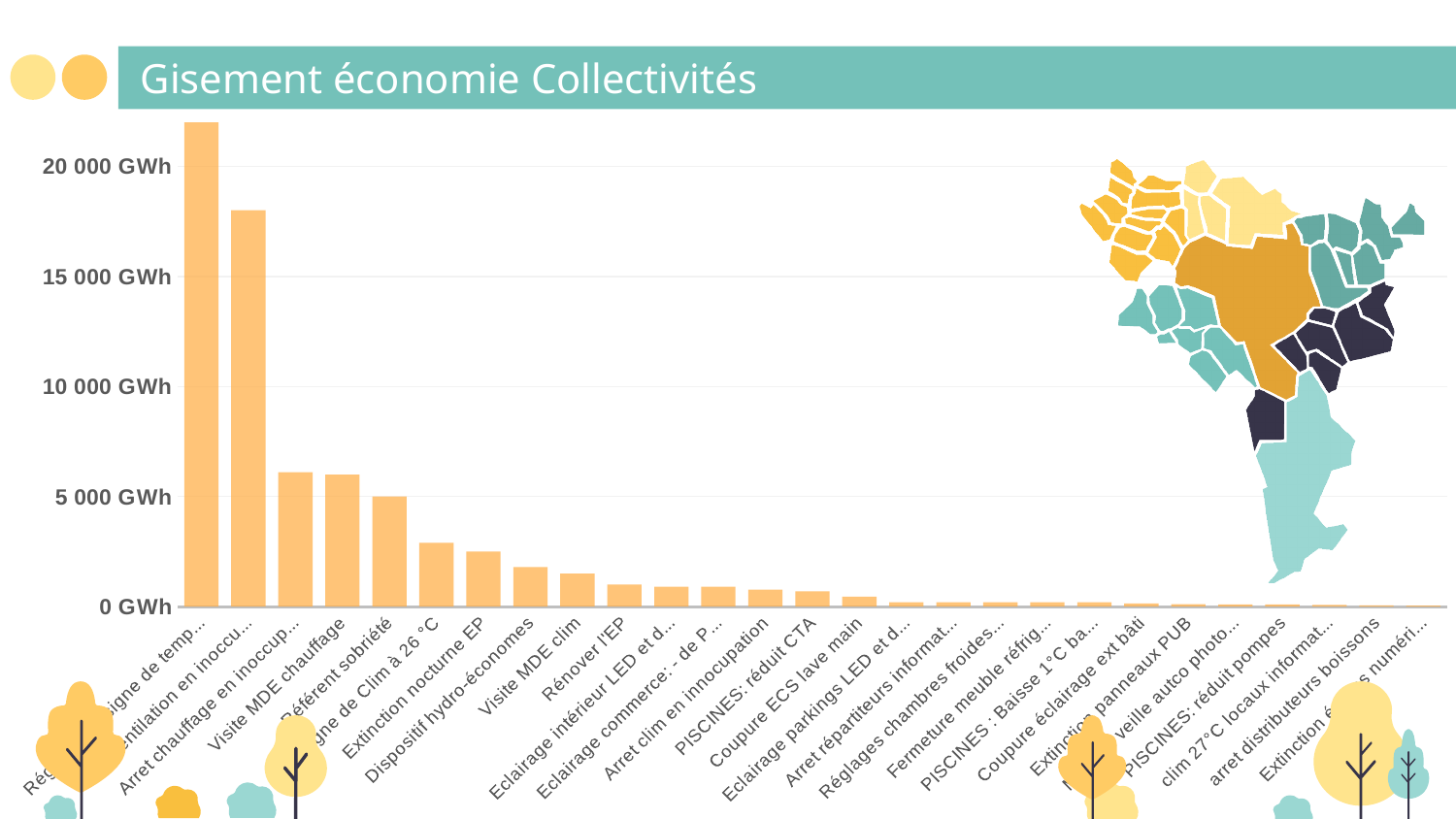
Is the value for Visite MDE chauffage greater or less than 5 000 GWh? greater Is the value for Rénover l'EP greater or less than 5 000 GWh? less What unit is used on the vertical axis of the chart? GWh What kind of chart is shown on the slide? bar chart Which is larger, the value for Visite MDE clim or the value for Rénover l'EP? Visite MDE clim Which is larger, the value for Visite MDE chauffage or the value for Extinction nocturne EP? Visite MDE chauffage What is the title of the chart? Gisement économie Collectivités Which is larger, the value for Référent sobriété or the value for Coupure ECS lave main? Référent sobriété Is the value for Visite MDE clim greater or less than 5 000 GWh? less Do the bar values rise or fall from left to right along the x axis? fall